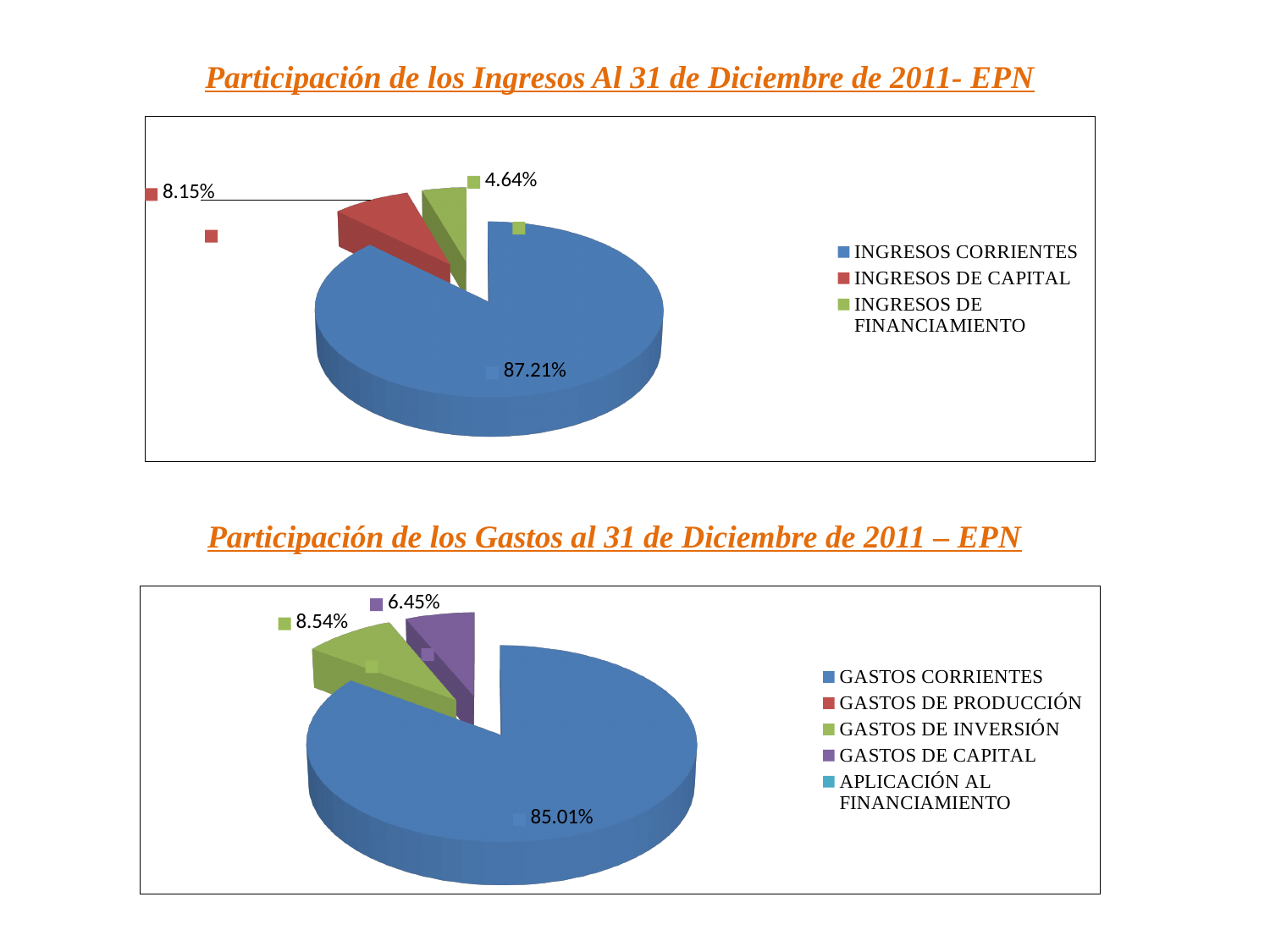
In the top chart (Participación de los Ingresos), which category has the smallest share? INGRESOS DE FINANCIAMIENTO In the top chart (Participación de los Ingresos), what percentage is shown for INGRESOS DE CAPITAL? 8.15% What type of chart is the top chart (Participación de los Ingresos)? Pie chart In the bottom chart (Participación de los Gastos), what percentage is shown for GASTOS DE INVERSIÓN? 8.54% In the top chart (Participación de los Ingresos), what is the difference in percentage points between INGRESOS DE CAPITAL and INGRESOS DE FINANCIAMIENTO? 3.51 In the top chart (Participación de los Ingresos), what percentage is shown for INGRESOS CORRIENTES? 87.21% In the top chart (Participación de los Ingresos), which category has the largest share? INGRESOS CORRIENTES In the bottom chart (Participación de los Gastos), what percentage is shown for GASTOS DE CAPITAL? 6.45% In the bottom chart (Participación de los Gastos), which is larger, GASTOS DE INVERSIÓN or GASTOS DE CAPITAL? GASTOS DE INVERSIÓN In the top chart (Participación de los Ingresos), what percentage is shown for INGRESOS DE FINANCIAMIENTO? 4.64% In the bottom chart (Participación de los Gastos), what percentage is shown for GASTOS CORRIENTES? 85.01% How many entries does the legend of the bottom chart (Participación de los Gastos) list? 5